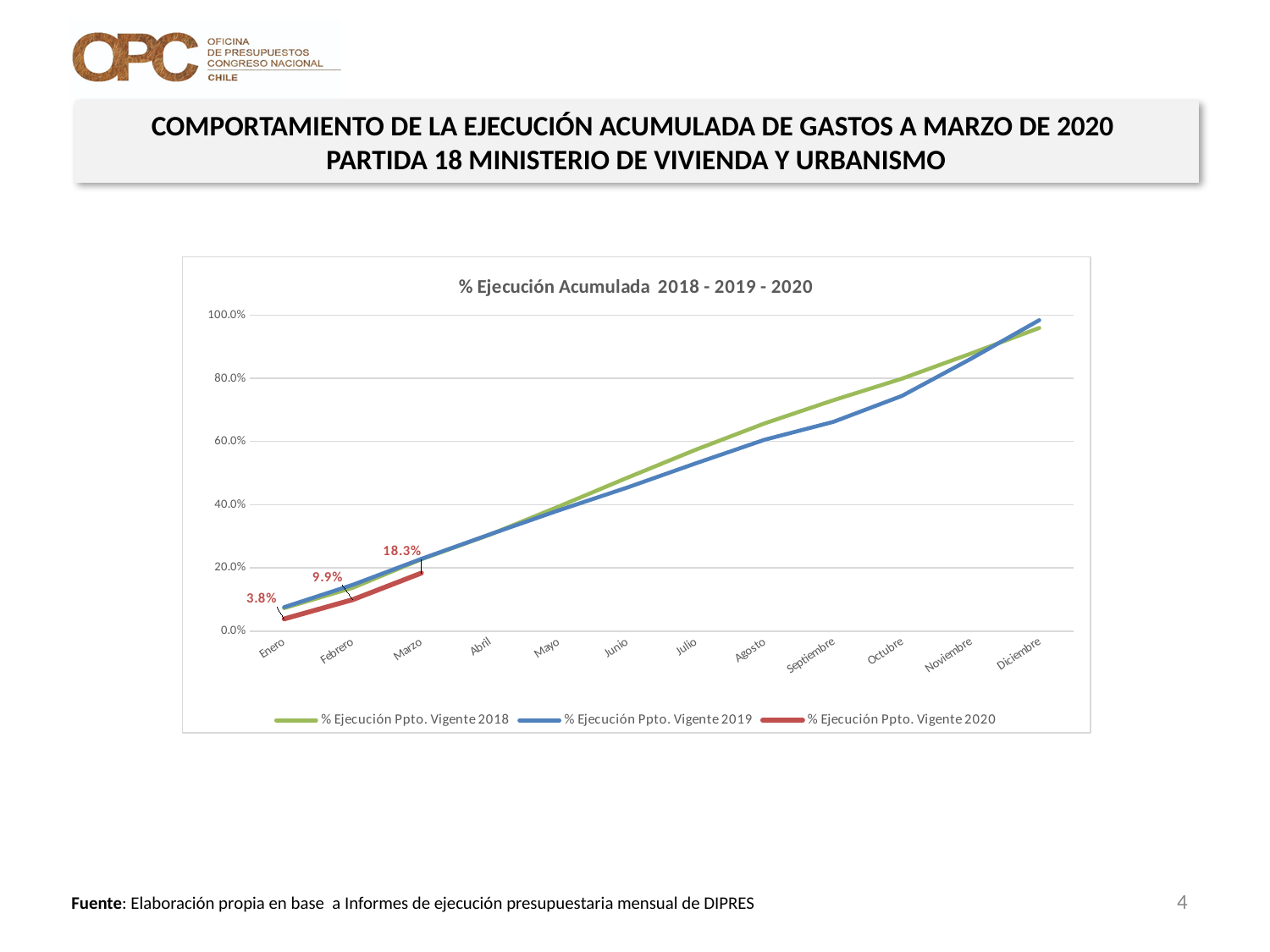
Which is larger in Marzo: the value for % Ejecución Ppto. Vigente 2019 or % Ejecución Ppto. Vigente 2020? % Ejecución Ppto. Vigente 2019 What is the value of % Ejecución Ppto. Vigente 2020 for Febrero? 9.9% How many series does the legend list? 3 What is the title of the chart? % Ejecución Acumulada 2018 - 2019 - 2020 What kind of chart is shown on the slide? Line chart Is the value for % Ejecución Ppto. Vigente 2019 in Diciembre greater or less than 80.0%? greater What is the difference between the 2020 values for Marzo and Febrero? 8.4% What is the difference between the 2020 values for Febrero and Enero? 6.1% How many months are shown on the x axis? 12 What is the value of % Ejecución Ppto. Vigente 2020 for Enero? 3.8% Do the values for % Ejecución Ppto. Vigente 2018 rise or fall from Enero to Diciembre? Rise What is the value of % Ejecución Ppto. Vigente 2020 for Marzo? 18.3%